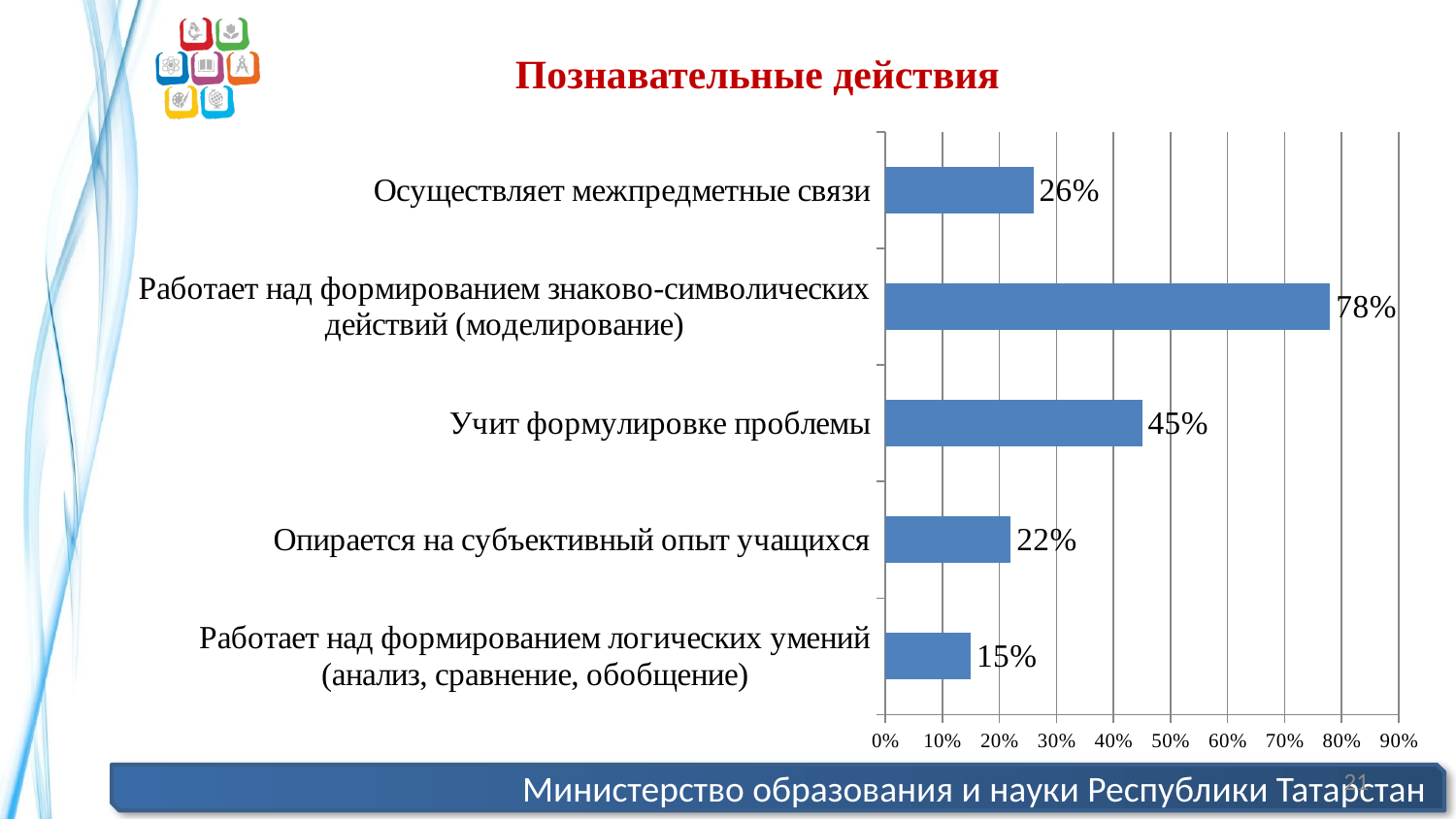
What is the difference between the values for "Работает над формированием знаково-символических действий (моделирование)" and "Учит формулировке проблемы"? 33% What is the title of the slide? Познавательные действия What kind of chart is shown on the slide? Bar chart What is the value for "Опирается на субъективный опыт учащихся"? 22% What is the value for "Работает над формированием логических умений (анализ, сравнение, обобщение)"? 15% What is the value for "Работает над формированием знаково-символических действий (моделирование)"? 78% Which category has the lowest value? Работает над формированием логических умений (анализ, сравнение, обобщение) Which is larger: the value for "Осуществляет межпредметные связи" or for "Опирается на субъективный опыт учащихся"? Осуществляет межпредметные связи What is the value for "Учит формулировке проблемы"? 45% Which category has the highest value? Работает над формированием знаково-символических действий (моделирование) How many categories are shown in the chart? 5 What is the value for "Осуществляет межпредметные связи"? 26%